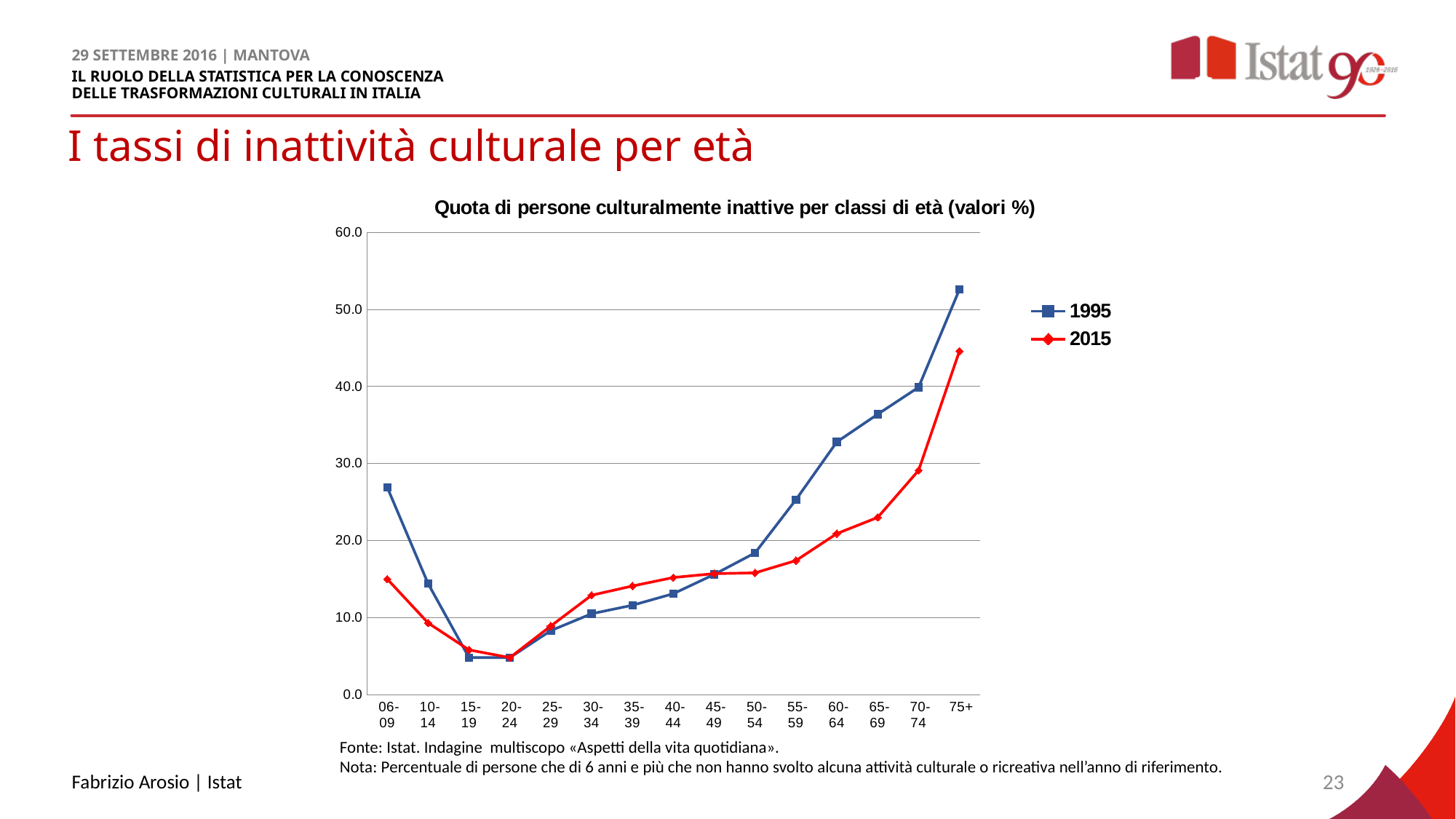
For the 1995 series, which age class has the highest value? 75+ Is the 1995 value for the 60-64 age class greater or less than 30.0? greater For the 30-34 age class, which series has the larger value, 1995 or 2015? 2015 What kind of chart is shown on the slide? Line chart For the 2015 series, which age class has the highest value? 75+ For the 06-09 age class, which series has the larger value, 1995 or 2015? 1995 How many age classes are shown on the x axis? 15 How many series does the legend list? 2 Is the 1995 value for the 75+ age class greater or less than 50.0? greater Is the 1995 value for the 06-09 age class greater or less than 20.0? greater Which colour is used for the 2015 series? Red